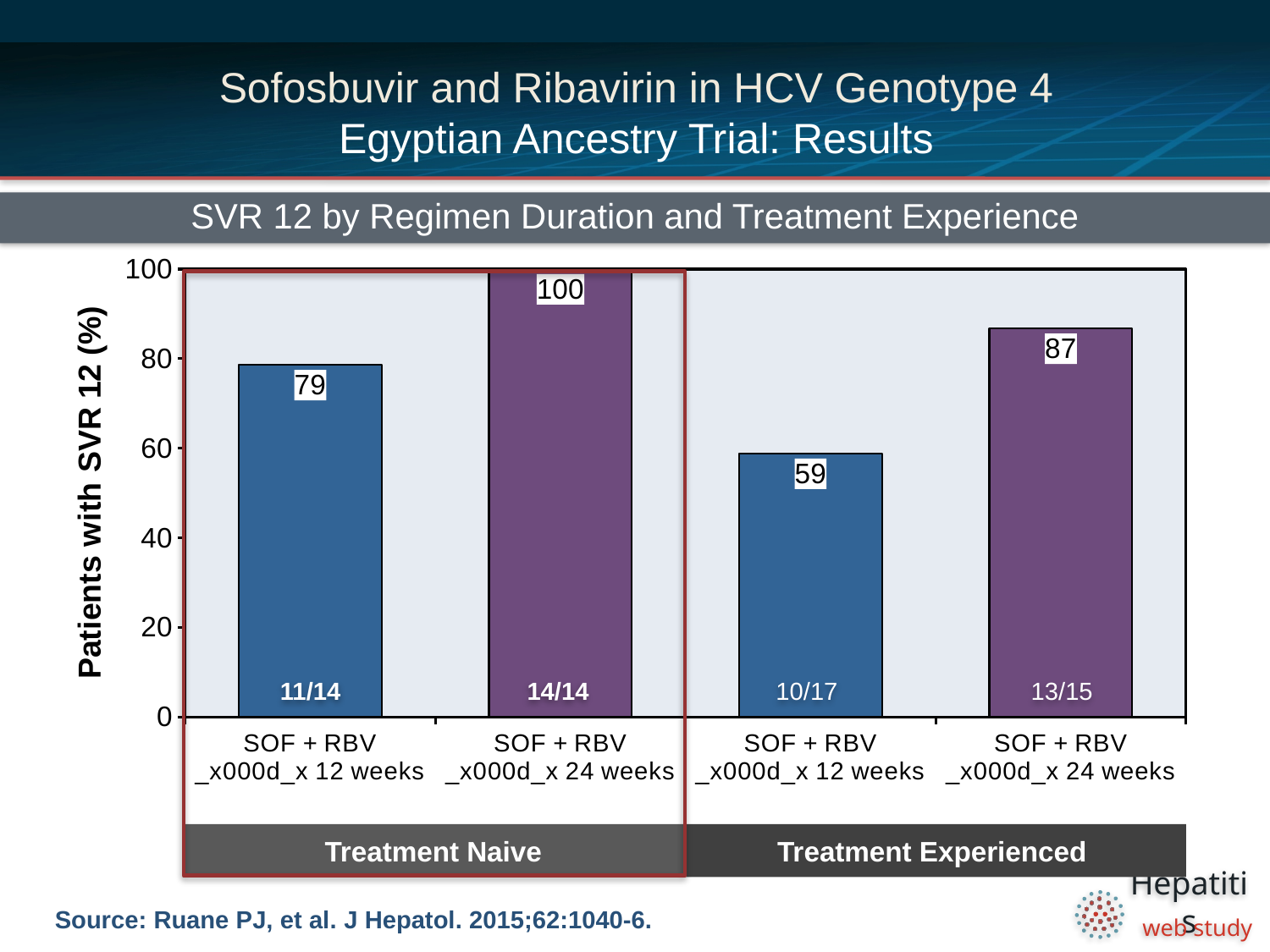
How many bars are shown in the chart? 4 What is the SVR 12 rate for SOF + RBV 12 weeks in the Treatment Experienced group? 59 What is the difference in SVR 12 rate between the 24-week and 12-week regimens in the Treatment Naive group? 21 Is the SVR 12 rate for SOF + RBV 12 weeks in the Treatment Experienced group greater or less than 60? less What kind of chart is shown on the slide? Bar chart What is the label on the y axis of the chart? Patients with SVR 12 (%) What is the SVR 12 rate for SOF + RBV 24 weeks in the Treatment Experienced group? 87 Which is larger: the SVR 12 rate for 12 weeks in the Treatment Naive group or for 24 weeks in the Treatment Experienced group? 24 weeks in the Treatment Experienced group Which bar has the highest SVR 12 rate? SOF + RBV 24 weeks, Treatment Naive What is the SVR 12 rate for SOF + RBV 12 weeks in the Treatment Naive group? 79 What is the difference in SVR 12 rate between the 24-week and 12-week regimens in the Treatment Experienced group? 28 Which bar has the lowest SVR 12 rate? SOF + RBV 12 weeks, Treatment Experienced